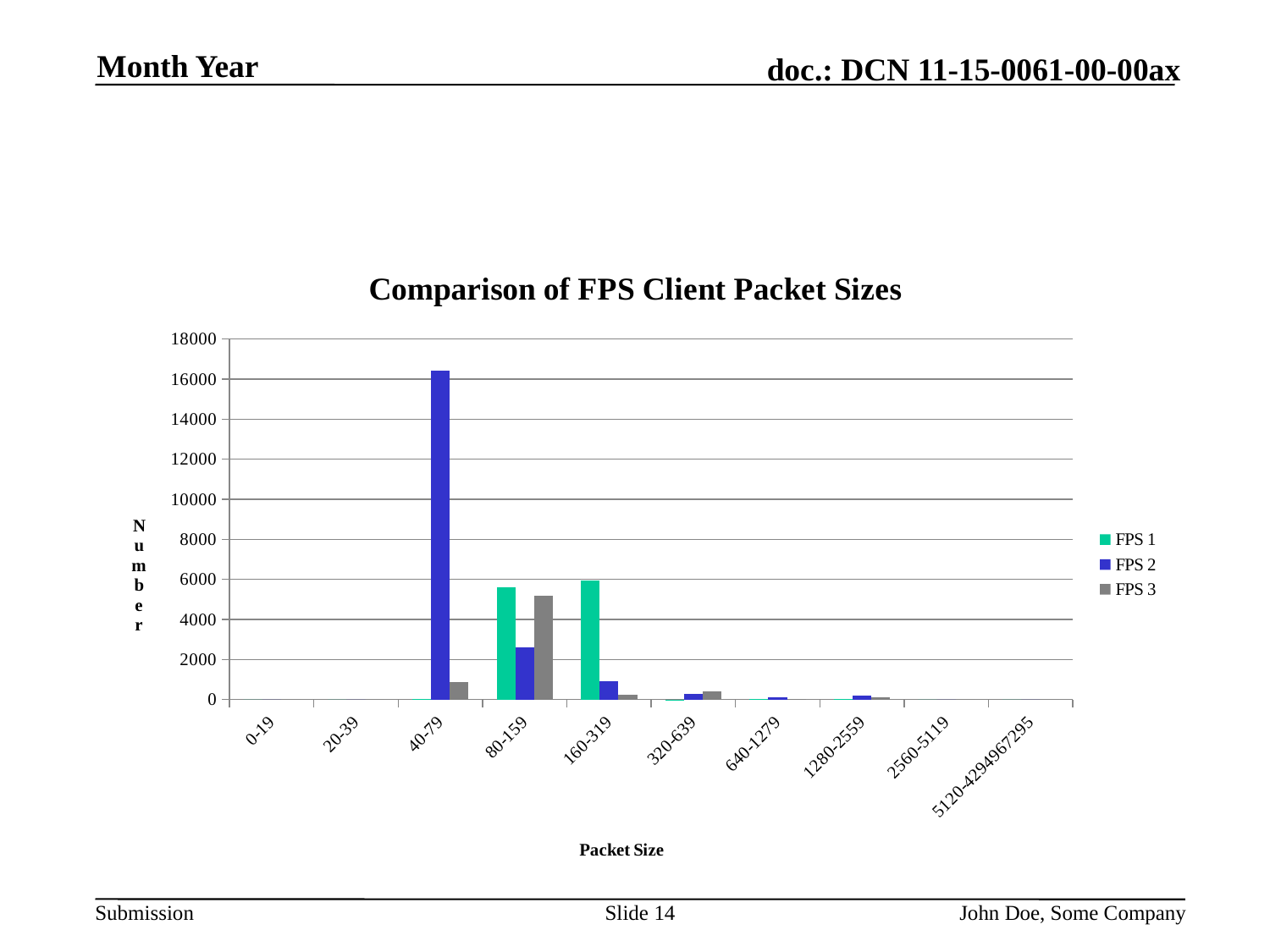
Which packet size category has the tallest bar in the chart? 40-79 How many packet size categories are shown on the x axis? 10 Is the value for FPS 3 in the 40-79 category greater or less than 2000? less Is the value for FPS 1 in the 80-159 category greater or less than 4000? greater What is the title of the chart? Comparison of FPS Client Packet Sizes In the 80-159 category, which is larger: FPS 1 or FPS 2? FPS 1 How many series does the legend list? 3 Is the value for FPS 2 in the 80-159 category greater or less than 2000? greater What type of chart is shown on the slide? bar chart Which series has the highest value in the 40-79 packet size category? FPS 2 What is the label of the x axis? Packet Size